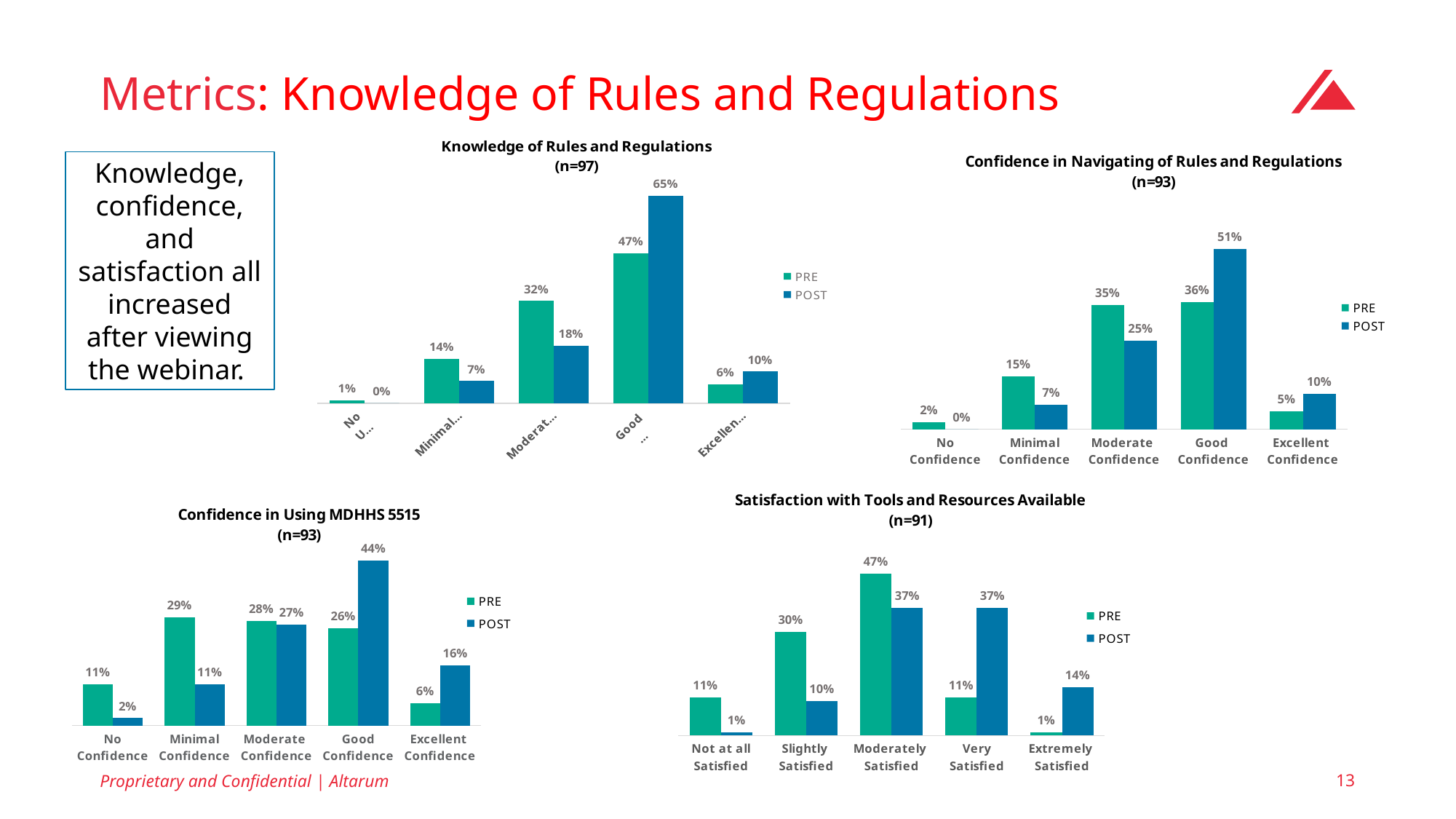
In the 'Knowledge of Rules and Regulations' chart, what is the POST value for the Good category? 65% In the 'Knowledge of Rules and Regulations' chart, what is the difference between the POST and PRE values for the Good category? 18% In the 'Satisfaction with Tools and Resources Available' chart, how many categories are shown on the x axis? 5 In the 'Confidence in Using MDHHS 5515' chart, what is the POST value for Excellent Confidence? 16% In the 'Confidence in Navigating of Rules and Regulations' chart, which category has the lowest POST value? No Confidence In the 'Confidence in Navigating of Rules and Regulations' chart, which category has the highest POST value? Good Confidence In the 'Confidence in Navigating of Rules and Regulations' chart, what is the PRE value for Moderate Confidence? 35% In the 'Satisfaction with Tools and Resources Available' chart, what is the PRE value for Moderately Satisfied? 47% In the 'Confidence in Using MDHHS 5515' chart, what is the difference between the PRE and POST values for No Confidence? 9% How many series does the legend of the 'Satisfaction with Tools and Resources Available' chart list? 2 What type of chart is the 'Confidence in Using MDHHS 5515' chart? Bar chart In the 'Confidence in Using MDHHS 5515' chart, which is larger for Good Confidence, the PRE value or the POST value? POST